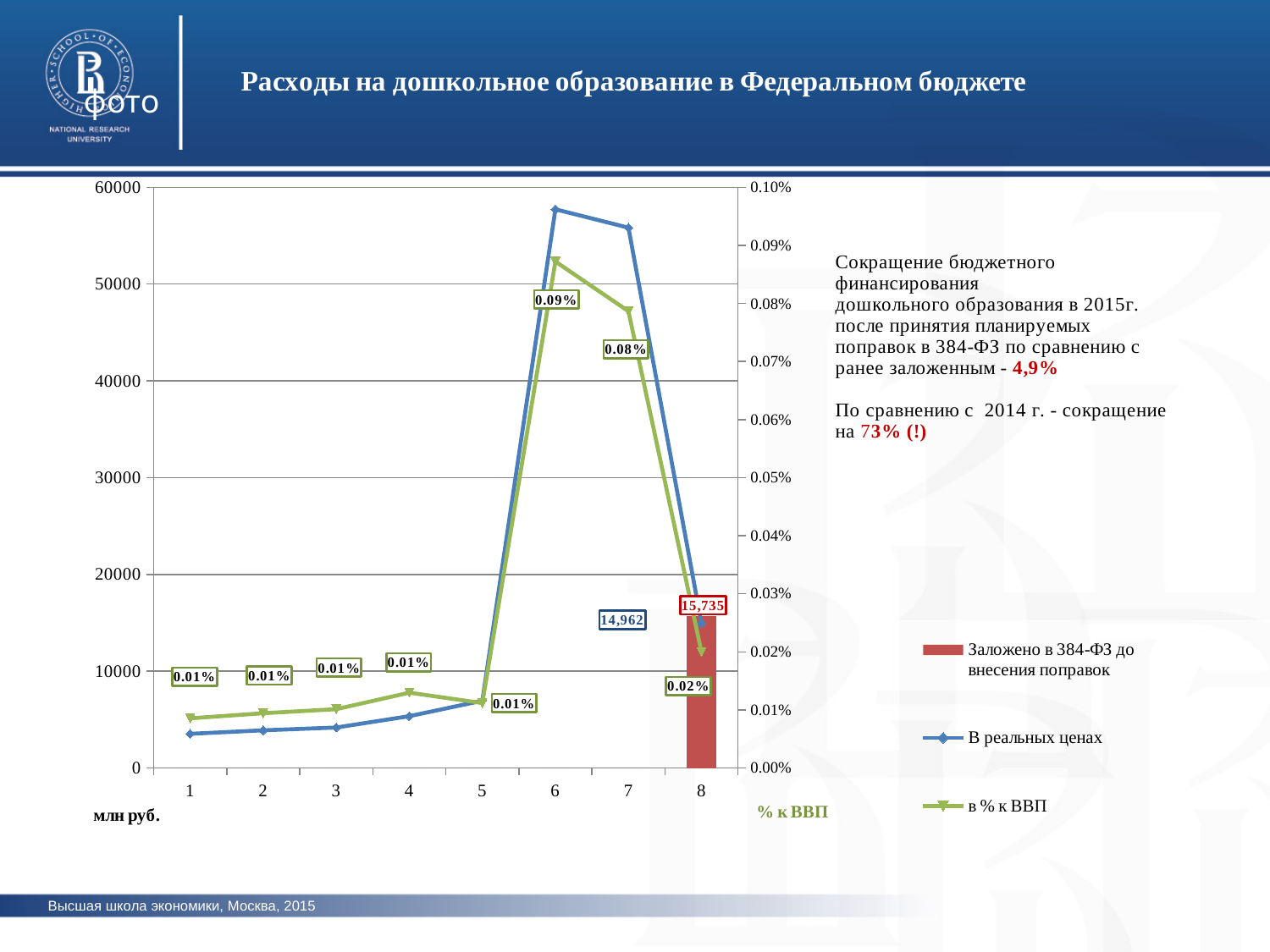
Is the value of 'В реальных ценах' at category 6 greater or less than 50000? greater At category 8, which is larger: 'Заложено в 384-ФЗ до внесения поправок' or 'В реальных ценах'? Заложено в 384-ФЗ до внесения поправок What is the value of the 'Заложено в 384-ФЗ до внесения поправок' bar at category 8? 15,735 What is the value of the 'В реальных ценах' series at category 8? 14,962 How many series does the legend list? 3 What is the value of the 'в % к ВВП' series at category 7? 0.08% What is the value of the 'в % к ВВП' series at category 6? 0.09% What is the difference between the 'Заложено в 384-ФЗ до внесения поправок' value (15,735) and the 'В реальных ценах' value (14,962) at category 8? 773 How many categories are shown on the x axis? 8 Is the value of 'В реальных ценах' at category 1 greater or less than 10000? less At which category does the 'в % к ВВП' series reach its highest value? 6 What is the value of the 'в % к ВВП' series at category 8? 0.02%